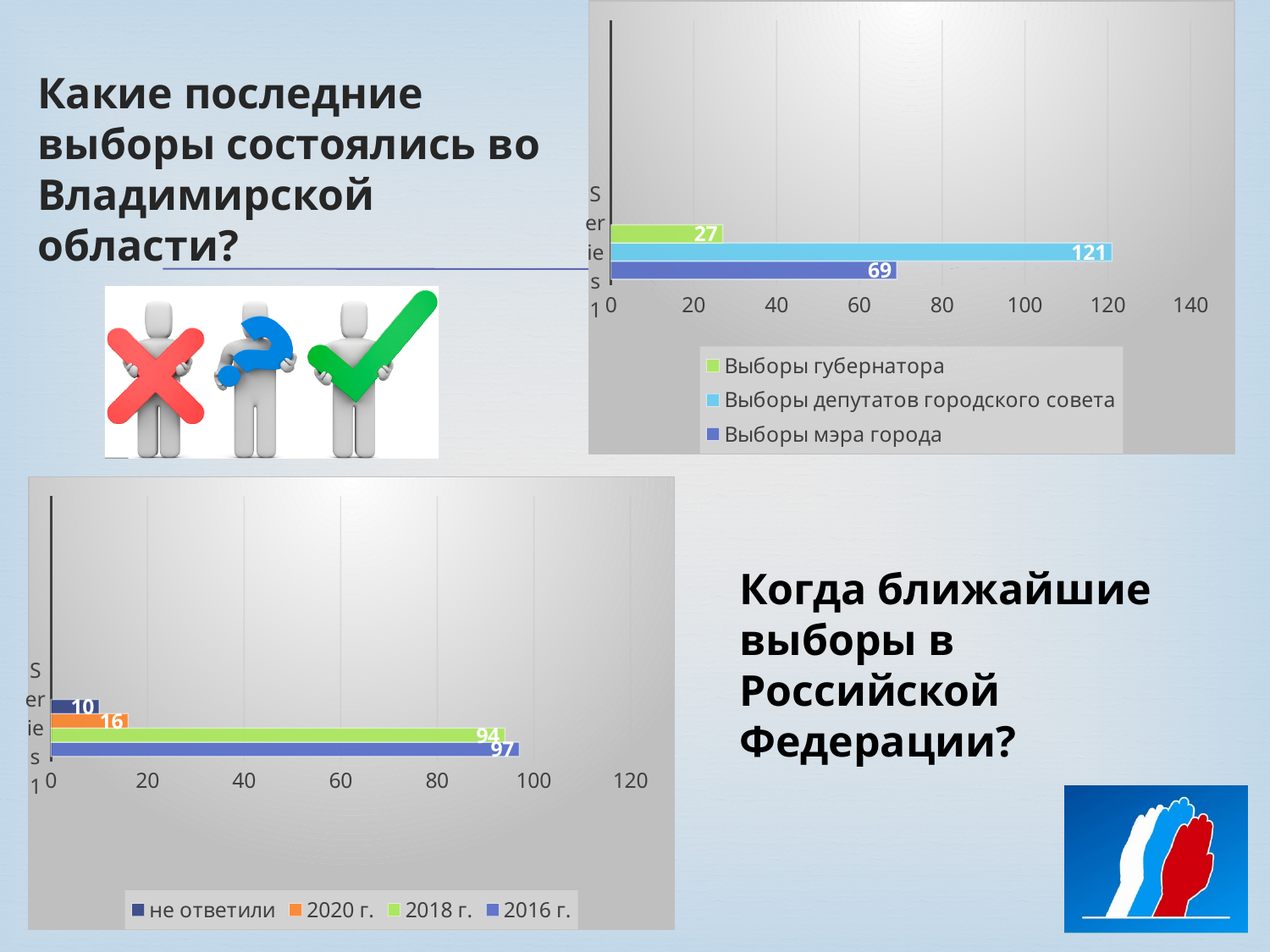
In the top-right chart, which series has the highest value? Выборы депутатов городского совета How many series does the legend of the bottom-left chart list? 4 In the top-right chart, which series has the lowest value? Выборы губернатора In the top-right chart, what is the value for Выборы губернатора? 27 How many series does the legend of the top-right chart list? 3 In the bottom-left chart, what is the value for 2020 г.? 16 In the bottom-left chart, what is the value for 2016 г.? 97 In the top-right chart, what is the value for Выборы депутатов городского совета? 121 In the top-right chart, what is the difference between the values for Выборы депутатов городского совета and Выборы мэра города? 52 In the bottom-left chart, what is the difference between the values for 2018 г. and 2020 г.? 78 In the bottom-left chart, which series has the lowest value? не ответили What kind of chart is the bottom-left chart? bar chart